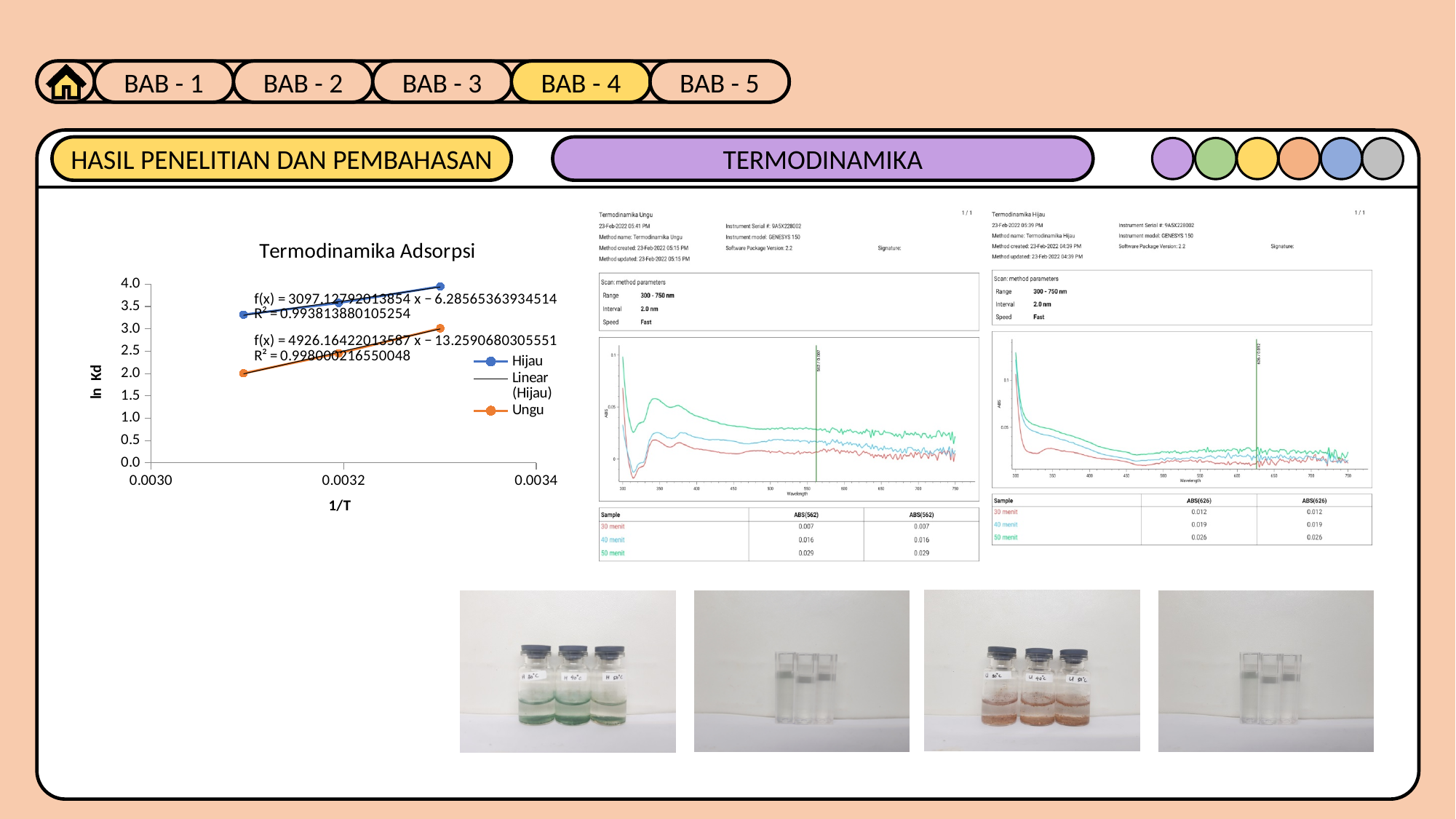
In the "Termodinamika Adsorpsi" chart, is the lowest Ungu value greater or less than 2.5? less What R² value is shown for the Ungu trendline in the "Termodinamika Adsorpsi" chart? 0.998000216550048 In the "Termodinamika Adsorpsi" chart, do the Hijau values rise or fall as 1/T increases? rise What is the y-axis label of the "Termodinamika Adsorpsi" chart? ln Kd In the "Termodinamika Adsorpsi" chart, which series has the higher ln Kd at the leftmost data point, Hijau or Ungu? Hijau What R² value is shown for the Hijau trendline in the "Termodinamika Adsorpsi" chart? 0.993813880105254 How many entries does the legend of the "Termodinamika Adsorpsi" chart list? 3 In the "Termodinamika Adsorpsi" chart, do the Ungu values rise or fall as 1/T increases? rise In the "Termodinamika Adsorpsi" chart, how many data points does the Hijau series have? 3 What is the title of the chart on the left of the slide? Termodinamika Adsorpsi In the "Termodinamika Adsorpsi" chart, is the highest Hijau value greater or less than 3.5? greater What kind of chart is "Termodinamika Adsorpsi"? line chart